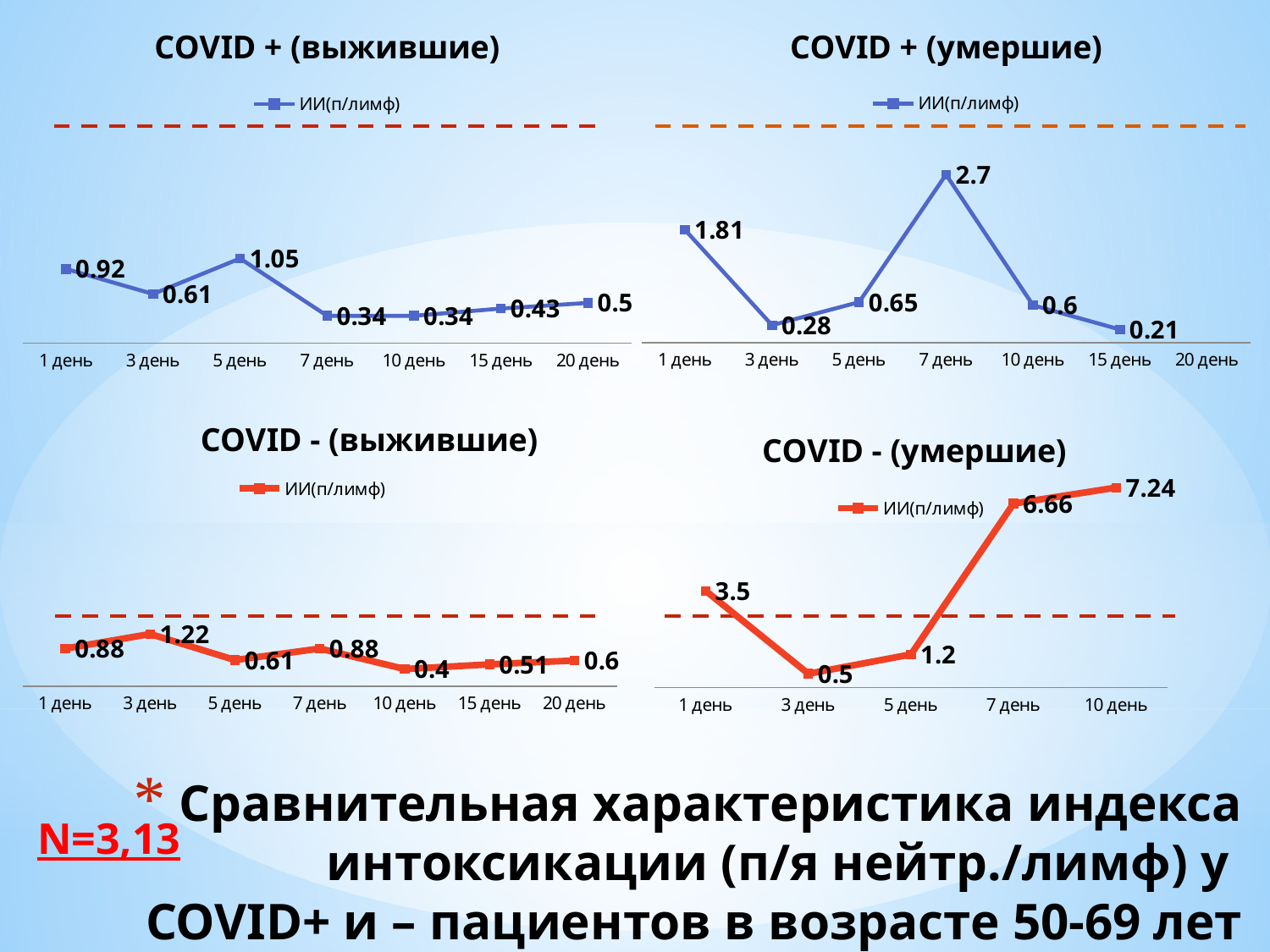
In the chart titled "COVID + (умершие)", what is the value for 15 день? 0.21 What kind of chart is the chart titled "COVID + (выжившие)"? Line chart In the chart titled "COVID - (выжившие)", which is larger: the value for 1 день or the value for 10 день? 1 день In the chart titled "COVID - (выжившие)", what is the value for 3 день? 1.22 In the chart titled "COVID + (умершие)", which day has the highest value? 7 день In the chart titled "COVID + (выжившие)", what is the value for 5 день? 1.05 What series name is shown in the legend of the chart titled "COVID + (умершие)"? ИИ(п/лимф) In the chart titled "COVID - (умершие)", do the values rise or fall from 5 день to 10 день? Rise In the chart titled "COVID - (умершие)", which day has the lowest value? 3 день How many data points are plotted in the chart titled "COVID - (умершие)"? 5 In the chart titled "COVID - (умершие)", what is the value for 10 день? 7.24 In the chart titled "COVID - (умершие)", what is the difference between the values for 10 день and 7 день? 0.58